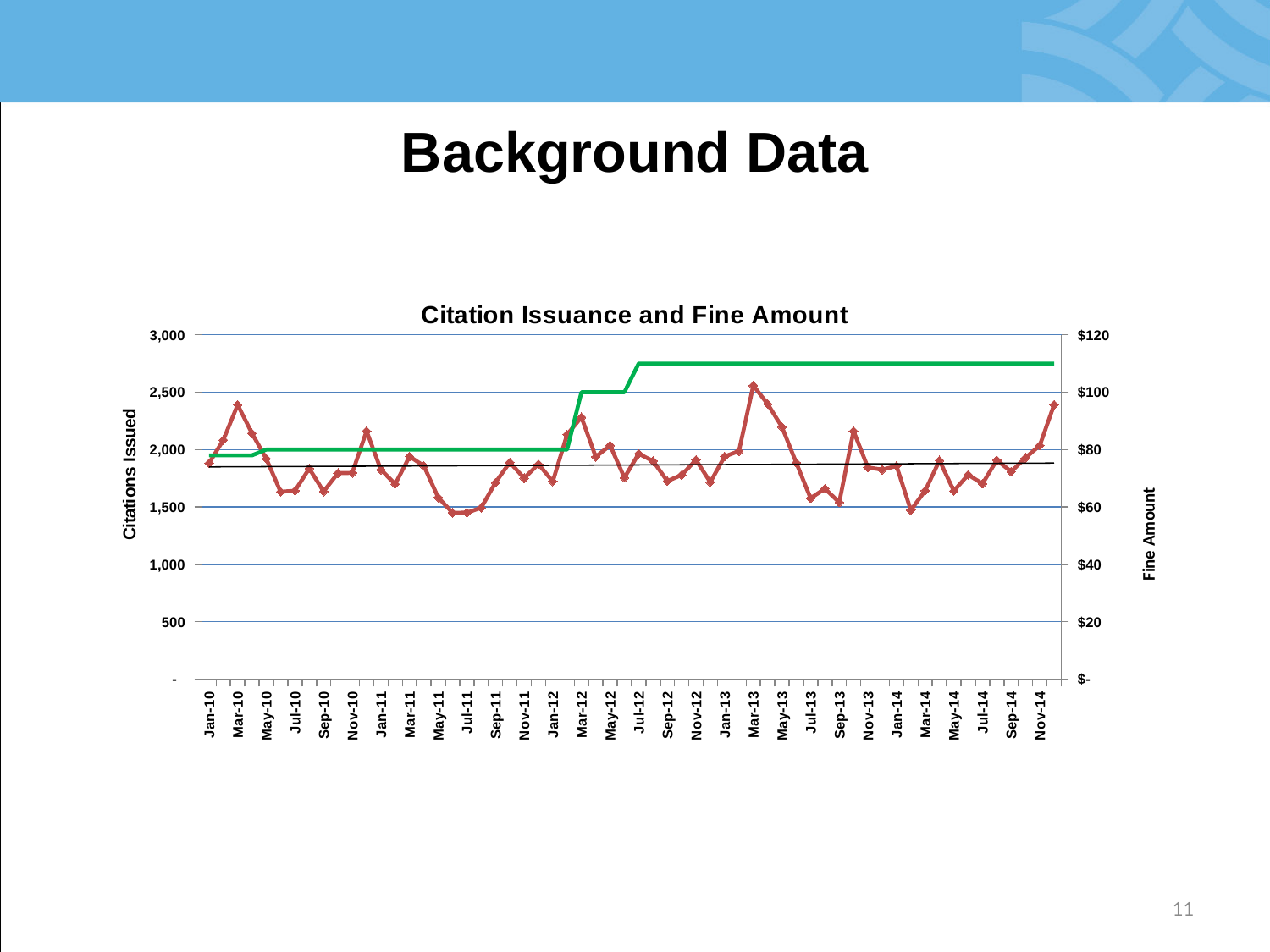
Which month had more citations issued, Mar-10 or Mar-13? Mar-13 What is the title of the chart? Citation Issuance and Fine Amount Does the fine amount rise or fall from Jan-10 to Nov-14? Rise Is the number of citations issued in Jul-11 greater or less than 1,500? less Is the number of citations issued in Mar-10 greater or less than 2,000? greater Which is larger, the fine amount in Jan-11 or the fine amount in Nov-14? Nov-14 In which month were the most citations issued? Mar-13 Is the fine amount in Jan-11 greater or less than $100? less What is the label of the left vertical axis? Citations Issued What type of chart is shown on the slide? Line chart